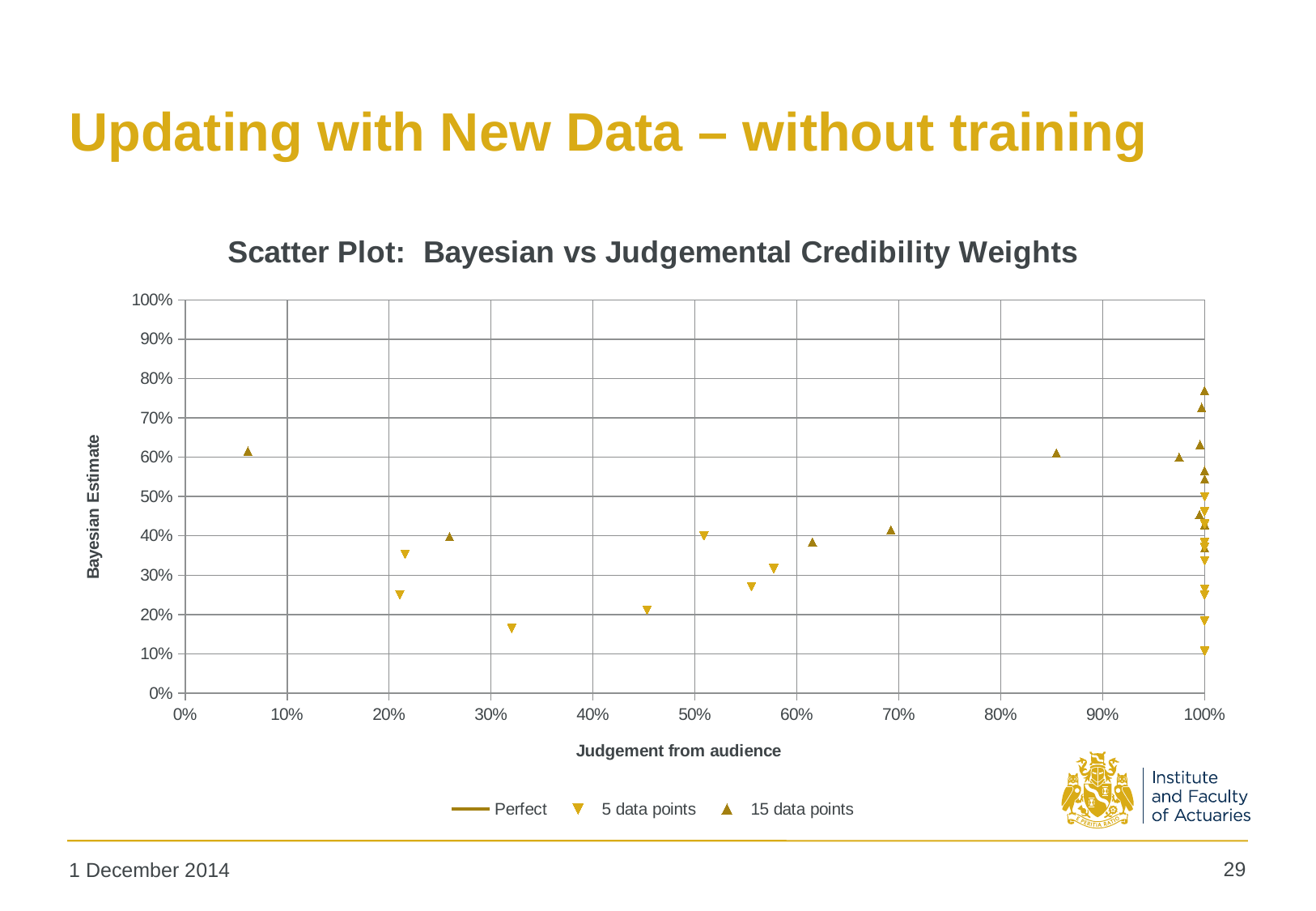
Is the Bayesian Estimate for the '15 data points' marker plotted near 90% on the x axis greater or less than 50%? greater Is the Bayesian Estimate for the '5 data points' marker plotted near 30% on the x axis greater or less than 30%? less What is the title of the chart? Scatter Plot: Bayesian vs Judgemental Credibility Weights What is the label of the chart's x axis? Judgement from audience Which series has the marker with the lowest Bayesian Estimate on the chart, '5 data points' or '15 data points'? 5 data points What is the label of the chart's y axis? Bayesian Estimate How many series does the chart's legend list? 3 What is the highest value shown on the y axis of the chart? 100% Which series has the marker with the highest Bayesian Estimate on the chart, '5 data points' or '15 data points'? 15 data points Is the Bayesian Estimate for the '5 data points' marker plotted near 50% on the x axis greater or less than 30%? greater What kind of chart is shown on the slide? Scatter plot